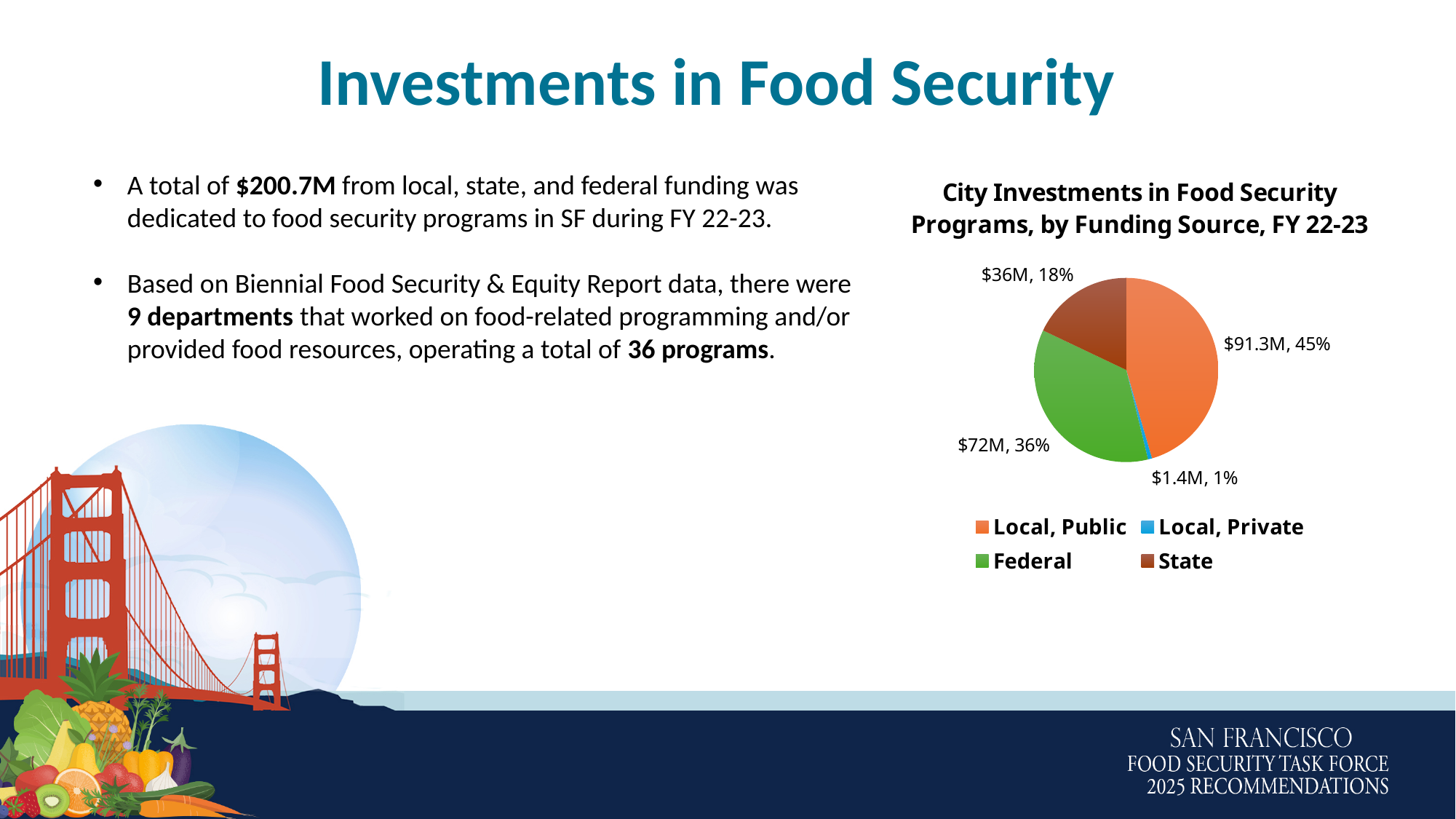
What is the value for Federal? $72M What is the title of the chart? City Investments in Food Security Programs, by Funding Source, FY 22-23 What is the difference between the Local, Public and Federal values? $19.3M What is the value for State? $36M Which is larger, the State value or the Federal value? Federal Which funding source has the largest share of the pie? Local, Public What type of chart is shown on the slide? pie chart Which funding source has the smallest share of the pie? Local, Private What is the value for Local, Public? $91.3M What is the value for Local, Private? $1.4M How many funding sources does the legend list? 4 What share of the pie does Federal represent? 36%